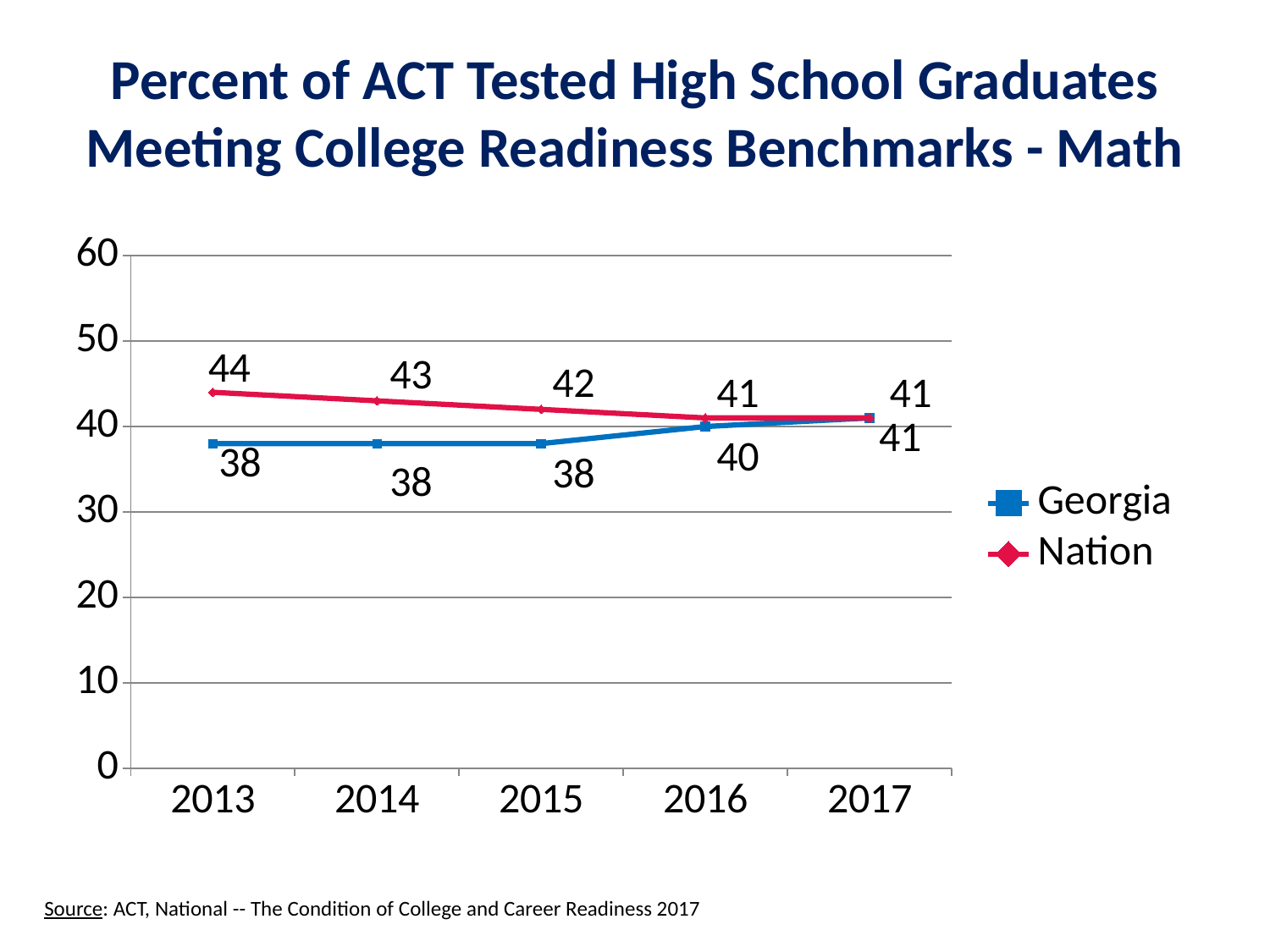
What is the value for Georgia in 2013? 38 What is the value for Georgia in 2016? 40 Does the Nation series rise or fall from 2013 to 2016? Fall How many years are shown on the x axis? 5 In which year is the Nation series highest? 2013 What is the lowest value shown for the Georgia series? 38 What kind of chart is shown on the slide? Line chart What is the value for Nation in 2014? 43 How many series does the legend list? 2 What is the difference between the Nation and Georgia values in 2013? 6 What is the value for Nation in 2017? 41 Which is larger in 2015, the Georgia value or the Nation value? Nation